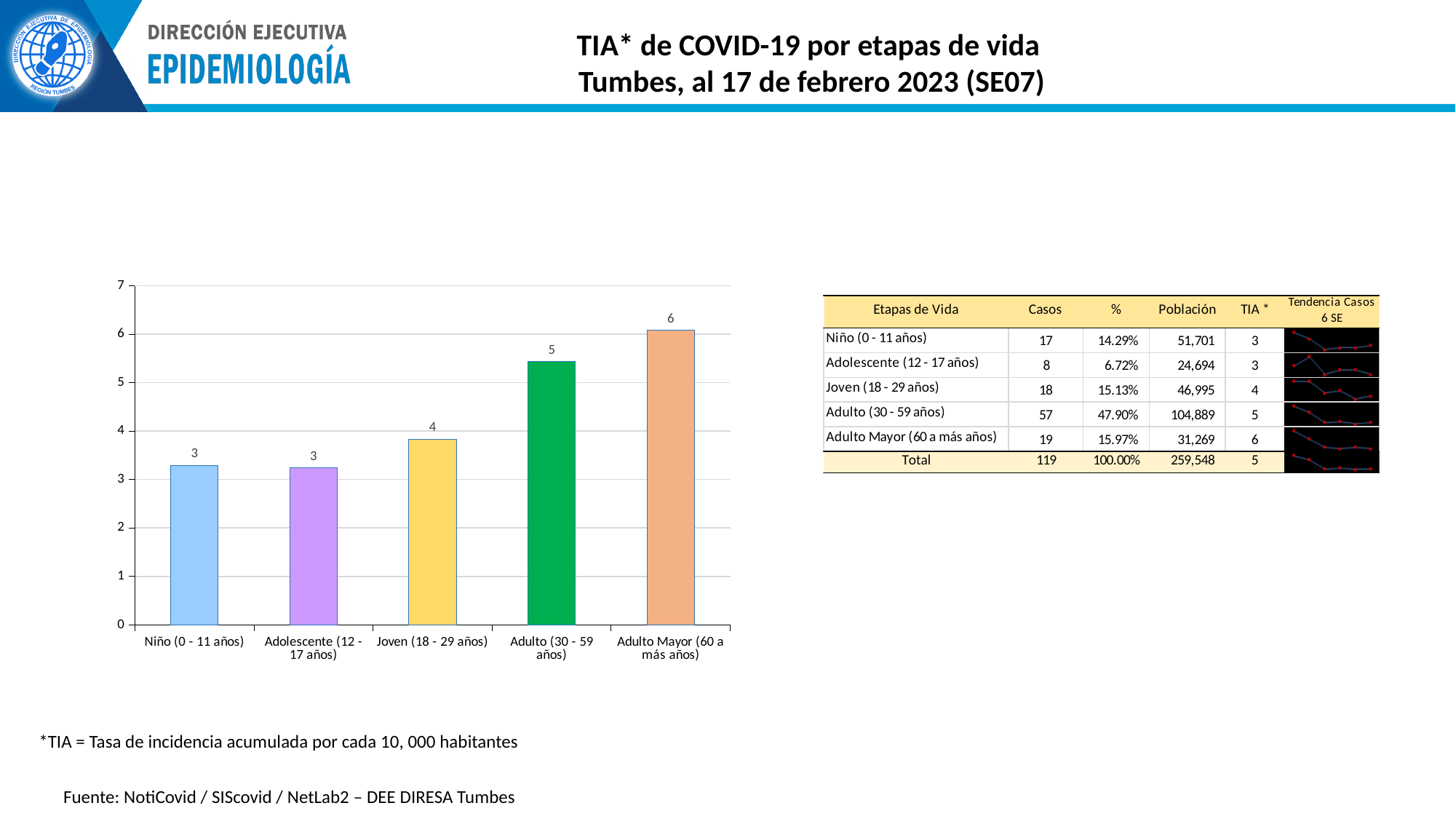
Is the value for Adolescente (12 - 17 años) greater or less than 4? less What is the TIA value shown for Niño (0 - 11 años)? 3 What is the TIA value shown for Adulto (30 - 59 años)? 5 Do the TIA values rise or fall moving from Niño to Adulto Mayor along the x axis? Rise What is the difference between the labelled TIA values for Adulto Mayor (60 a más años) and Adulto (30 - 59 años)? 1 What is the TIA value shown for Joven (18 - 29 años)? 4 Which has a higher TIA, Adulto (30 - 59 años) or Joven (18 - 29 años)? Adulto (30 - 59 años) Which life stage has the highest TIA in the bar chart? Adulto Mayor (60 a más años) Is the value for Adulto Mayor (60 a más años) greater or less than 5? greater What is the TIA value shown for Adulto Mayor (60 a más años)? 6 How many life-stage categories are plotted in the bar chart? 5 What kind of chart is used to show the TIA by life stage? Bar chart